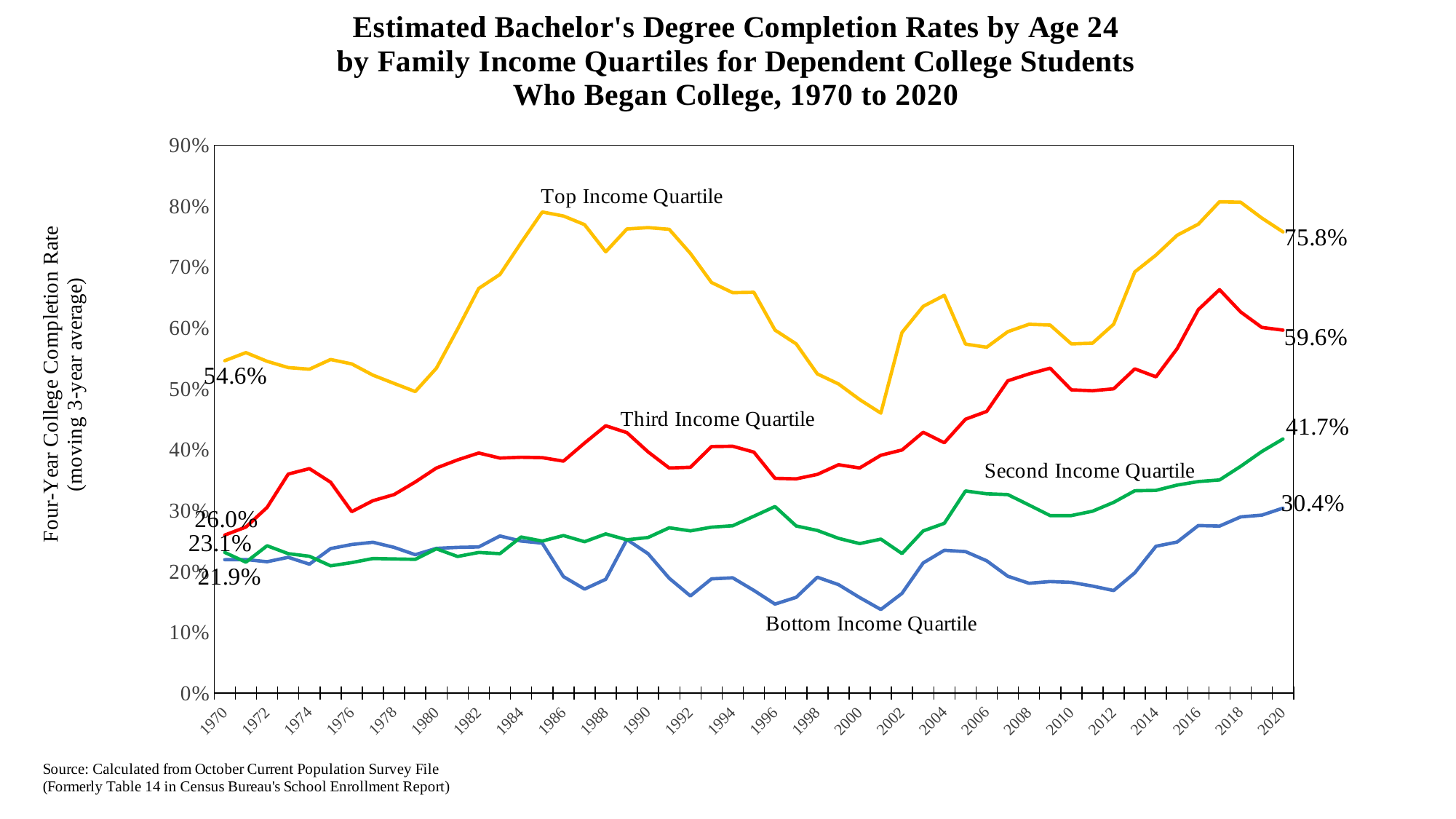
What was the completion rate for the Top Income Quartile in 1970? 54.6% What is the difference between the Top Income Quartile and Third Income Quartile completion rates in 2020? 16.2 percentage points What is the completion rate for the Bottom Income Quartile in 2020? 30.4% Which income quartile has the lowest completion rate in 2020? Bottom Income Quartile Is the value for the Bottom Income Quartile in 2001 greater or less than 20%? less What is the completion rate for the Top Income Quartile in 2020? 75.8% What is the completion rate for the Second Income Quartile in 2020? 41.7% What type of chart is shown on the slide? Line chart By how many percentage points did the Top Income Quartile completion rate change from 1970 (54.6%) to 2020 (75.8%)? 21.2 percentage points Which income quartile has the highest completion rate in 2020? Top Income Quartile What is the completion rate for the Third Income Quartile in 2020? 59.6% How many income quartile series are plotted on the chart? 4